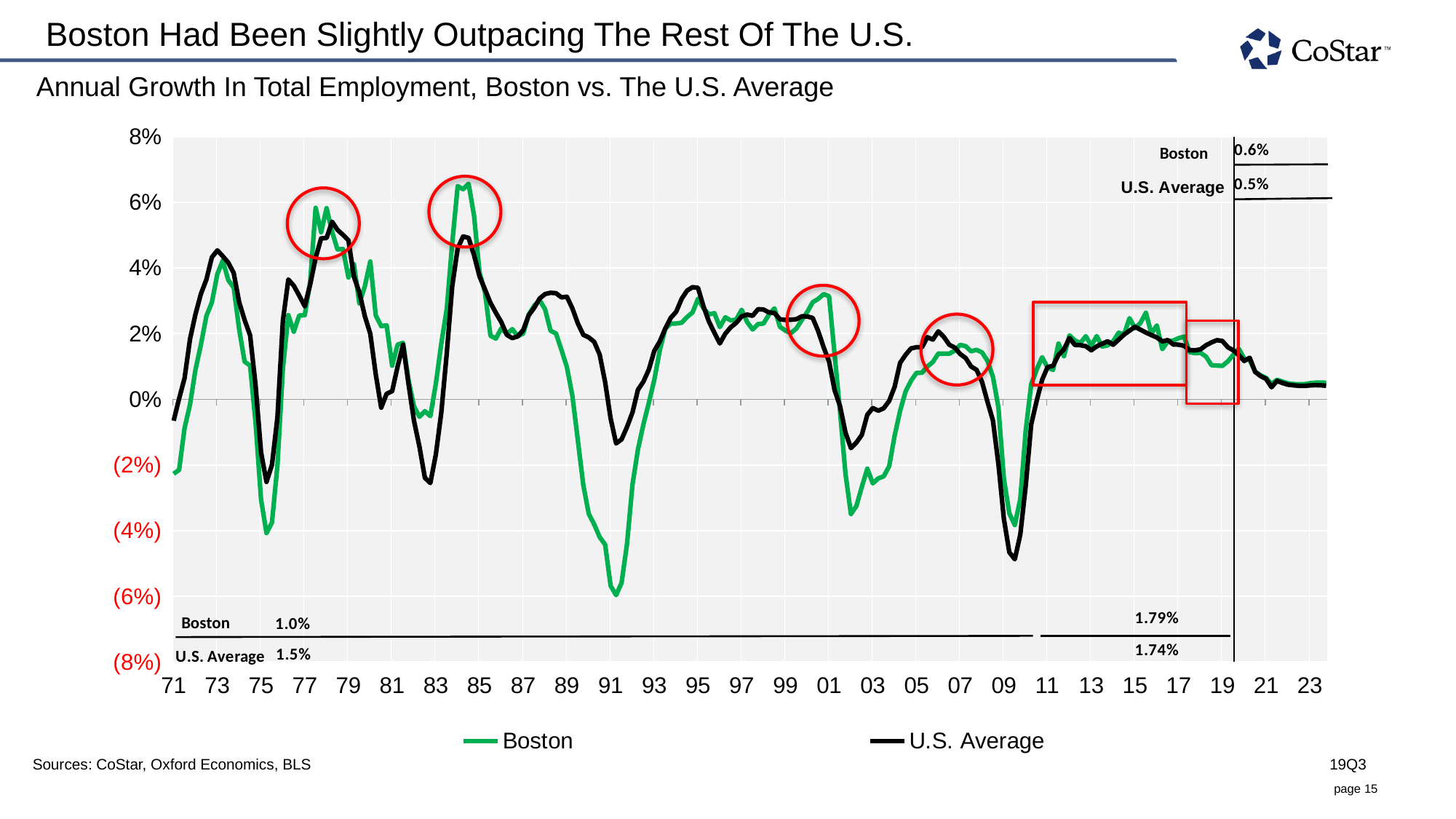
What average growth value is printed for the U.S. Average for the 2011-2019 period (the right-hand annotation at the bottom of the chart)? 1.74% In the bottom-left annotation for the earlier period, which is larger: the Boston value of 1.0% or the U.S. Average value of 1.5%? U.S. Average Which two series are listed in the legend? Boston and U.S. Average What is the title of the chart? Annual Growth In Total Employment, Boston vs. The U.S. Average What kind of chart is shown on the slide? line chart What forecast value is printed for Boston in the top-right annotation? 0.6% What is the difference between the Boston (1.79%) and U.S. Average (1.74%) values printed for the 2011-2019 period? 0.05% Is the Boston value at its low point around 1991 greater or less than (4%)? less What forecast value is printed for the U.S. Average in the top-right annotation? 0.5% How many series does the legend list? 2 Is the Boston value at its peak around 1984 greater or less than 4%? greater What average growth value is printed for Boston for the 2011-2019 period (the right-hand annotation at the bottom of the chart)? 1.79%